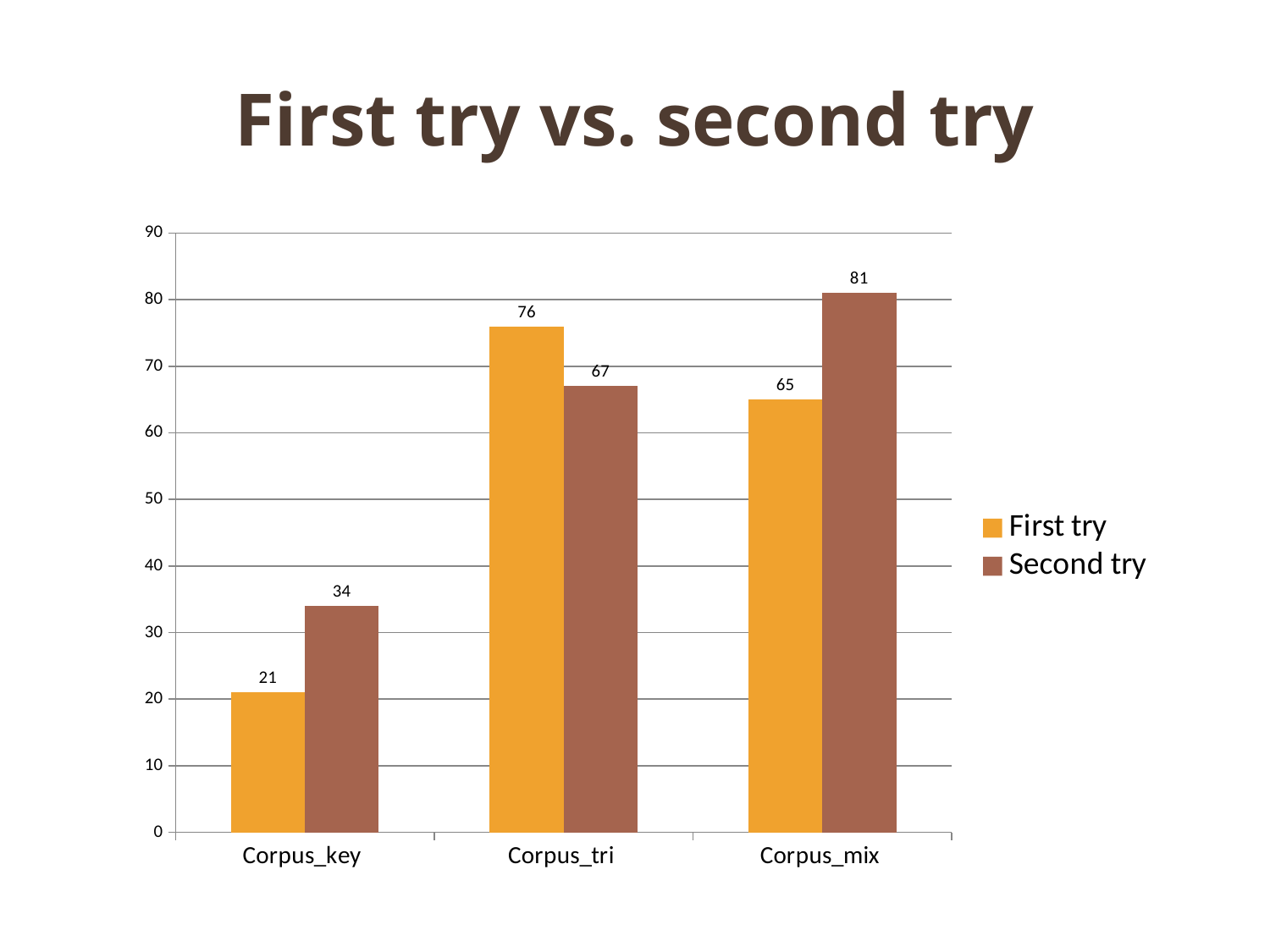
What is the Second try value for Corpus_mix? 81 What is the difference between the Second try and First try values for Corpus_mix? 16 How many categories are shown on the x axis? 3 Which category has the lowest Second try value? Corpus_key What is the First try value for Corpus_key? 21 Is the First try value for Corpus_mix greater or less than 60? greater What is the Second try value for Corpus_tri? 67 What is the difference between the Second try and First try values for Corpus_key? 13 Which category has the highest First try value? Corpus_tri How many series does the legend list? 2 What kind of chart is shown on the slide? Bar chart For Corpus_tri, which is larger: the First try value or the Second try value? First try